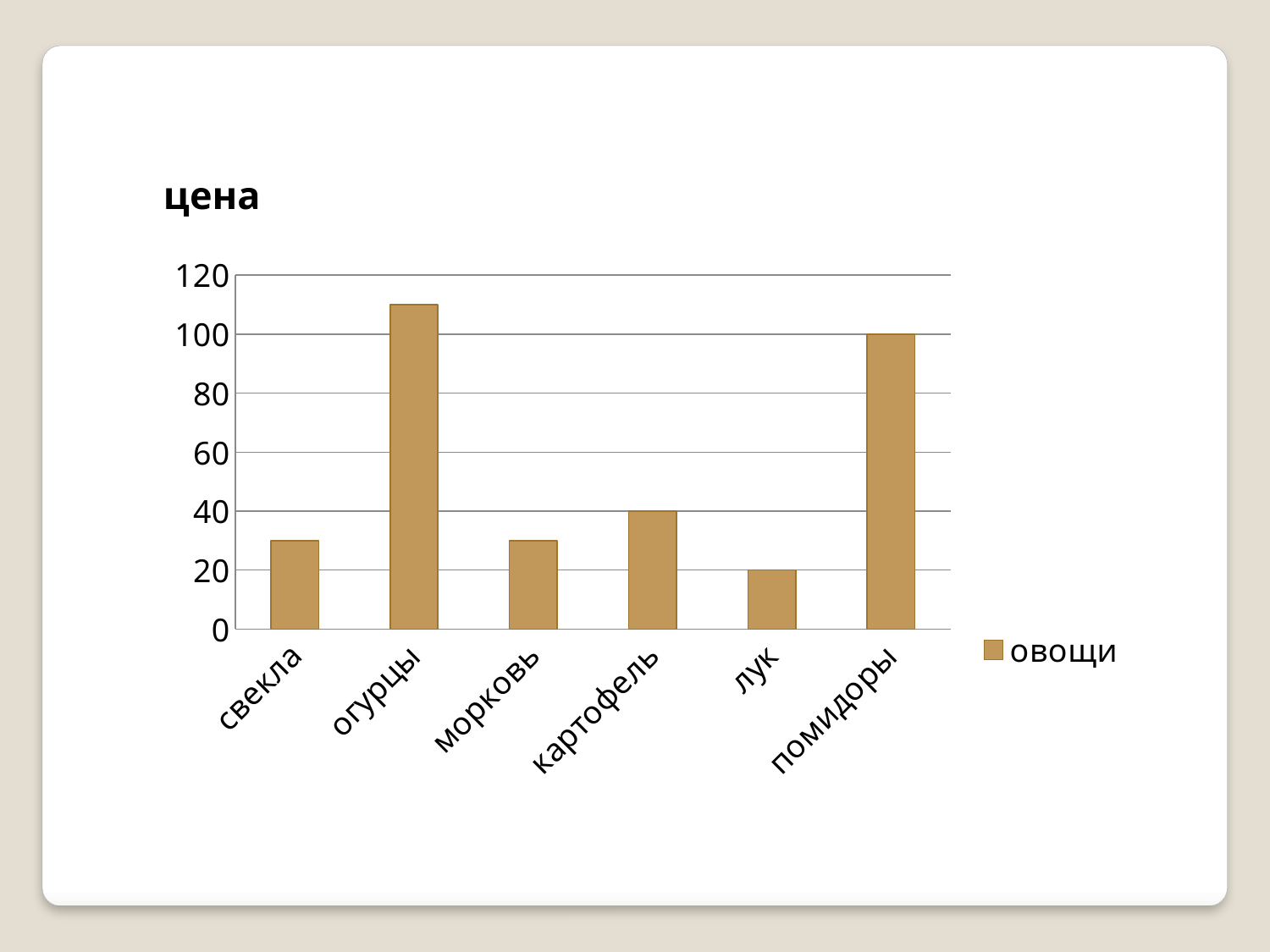
What is the difference between the values for помидоры and картофель? 60 Which category has the lowest value? лук What is the value for картофель? 40 Which is larger, the value for огурцы or the value for помидоры? огурцы Which category has the highest value? огурцы What is the value for лук? 20 What is the value for помидоры? 100 Is the value for огурцы greater or less than 100? greater How many categories are shown on the x axis? 6 Is the value for свекла greater or less than 40? less How many series does the legend list? 1 What is the title of the chart? цена